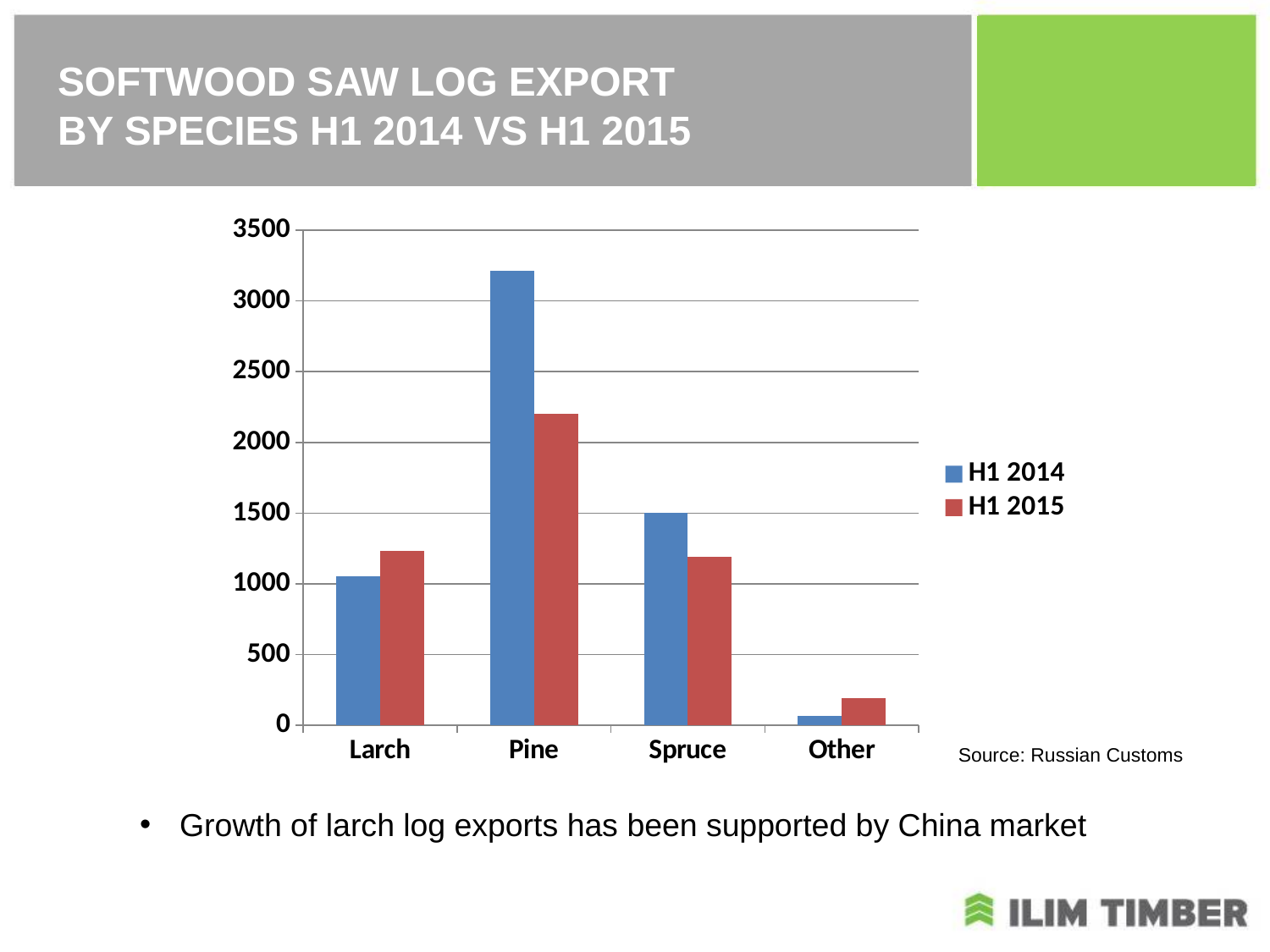
What kind of chart is shown on the slide? bar chart Which species has the lowest H1 2015 export value? Other For Larch, which is larger: the H1 2014 value or the H1 2015 value? H1 2015 Is the H1 2014 value for Pine greater or less than 3000? greater How many series does the legend list? 2 Is the H1 2015 value for Larch greater or less than 1000? greater Is the H1 2015 value for Pine greater or less than 2500? less How many species categories are shown on the x axis? 4 Which species has the highest H1 2014 export value? Pine For Spruce, which is larger: the H1 2014 value or the H1 2015 value? H1 2014 What is the source cited for the chart data? Russian Customs